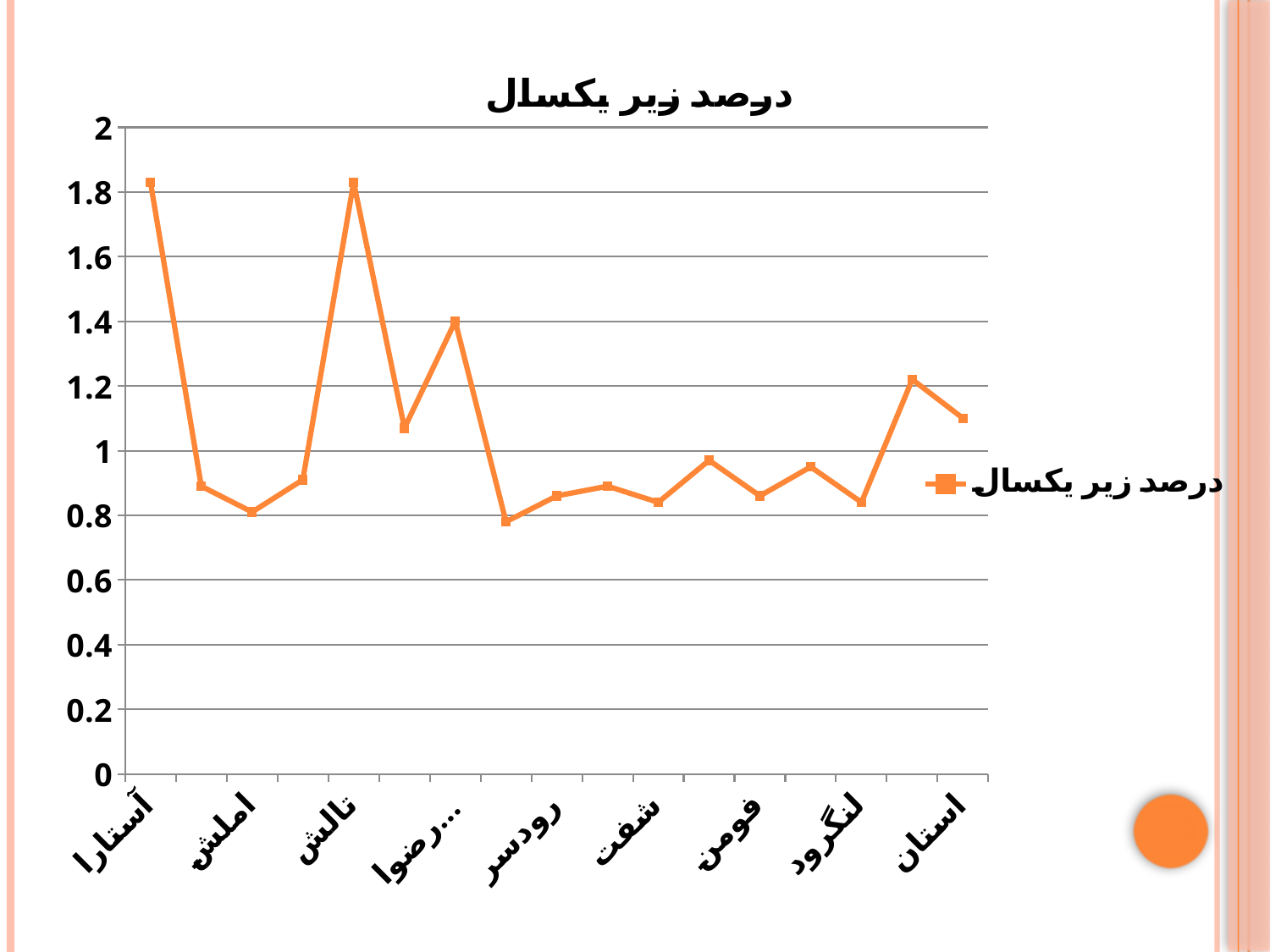
Which has the larger value, استان or شفت? استان Is the value for رودسر greater or less than 1? less How many series does the legend list? 1 What colour is the plotted line? orange Is the value for تالش greater or less than 1.4? greater Is the value for استان greater or less than 1? greater Which has the larger value, آستارا or املش? آستارا Which has the larger value, تالش or رودسر? تالش What is the title of the chart? درصد زیر یکسال What type of chart is shown on the slide? line chart